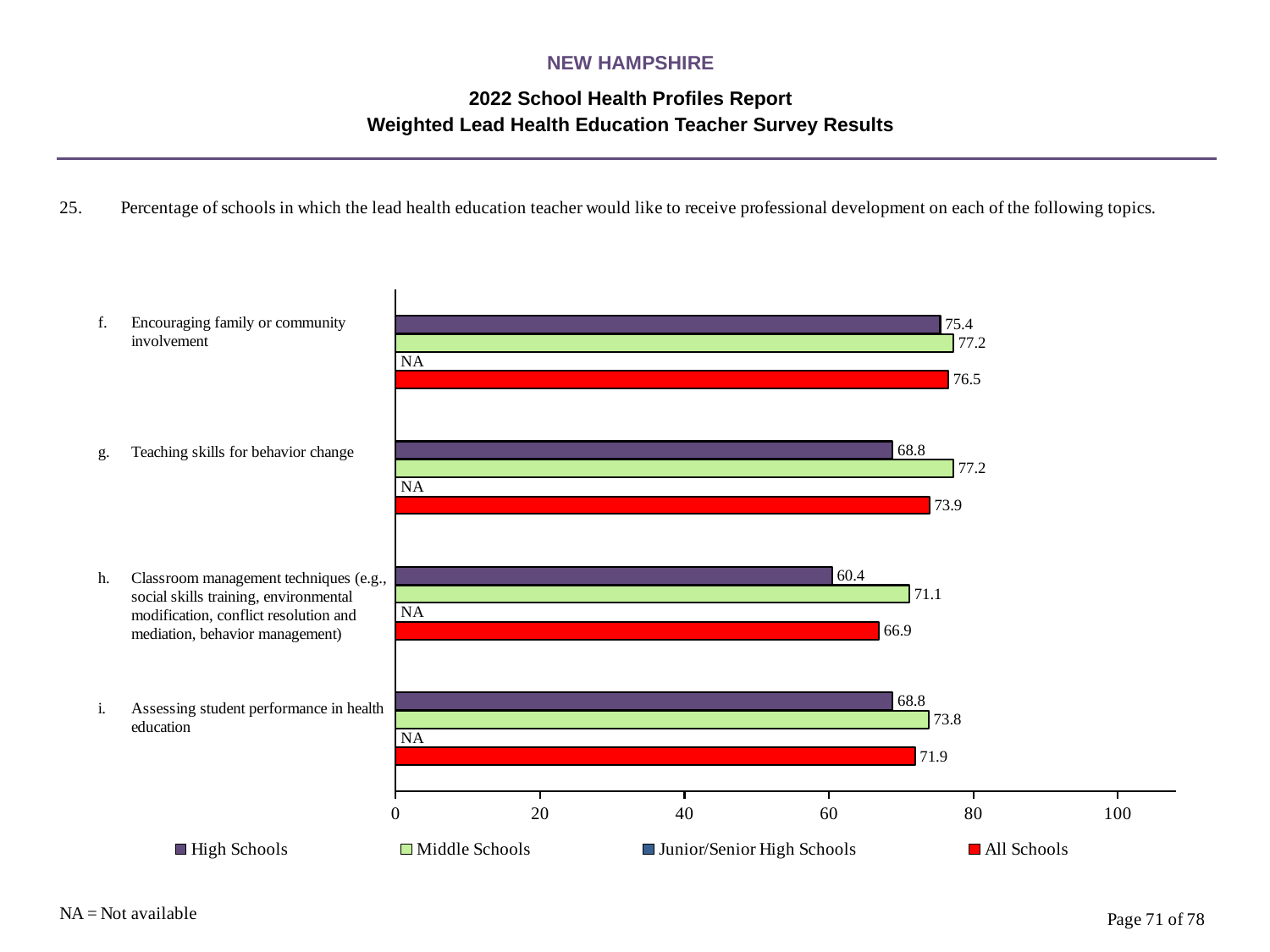
What is the value for Middle Schools for 'Teaching skills for behavior change'? 77.2 What is the value for High Schools for 'Encouraging family or community involvement'? 75.4 Which topic has the lowest High Schools value? Classroom management techniques What is the value for Middle Schools for 'Assessing student performance in health education'? 73.8 How many topics are shown on the chart? 4 Which is larger for 'Teaching skills for behavior change': the High Schools value or the All Schools value? All Schools What is the difference between the Middle Schools and High Schools values for 'Classroom management techniques'? 10.7 What is the value for All Schools for 'Classroom management techniques'? 66.9 Which topic has the highest All Schools value? Encouraging family or community involvement What kind of chart is shown on the slide? Bar chart How many series does the legend list? 4 What value is shown for Junior/Senior High Schools for each topic? NA